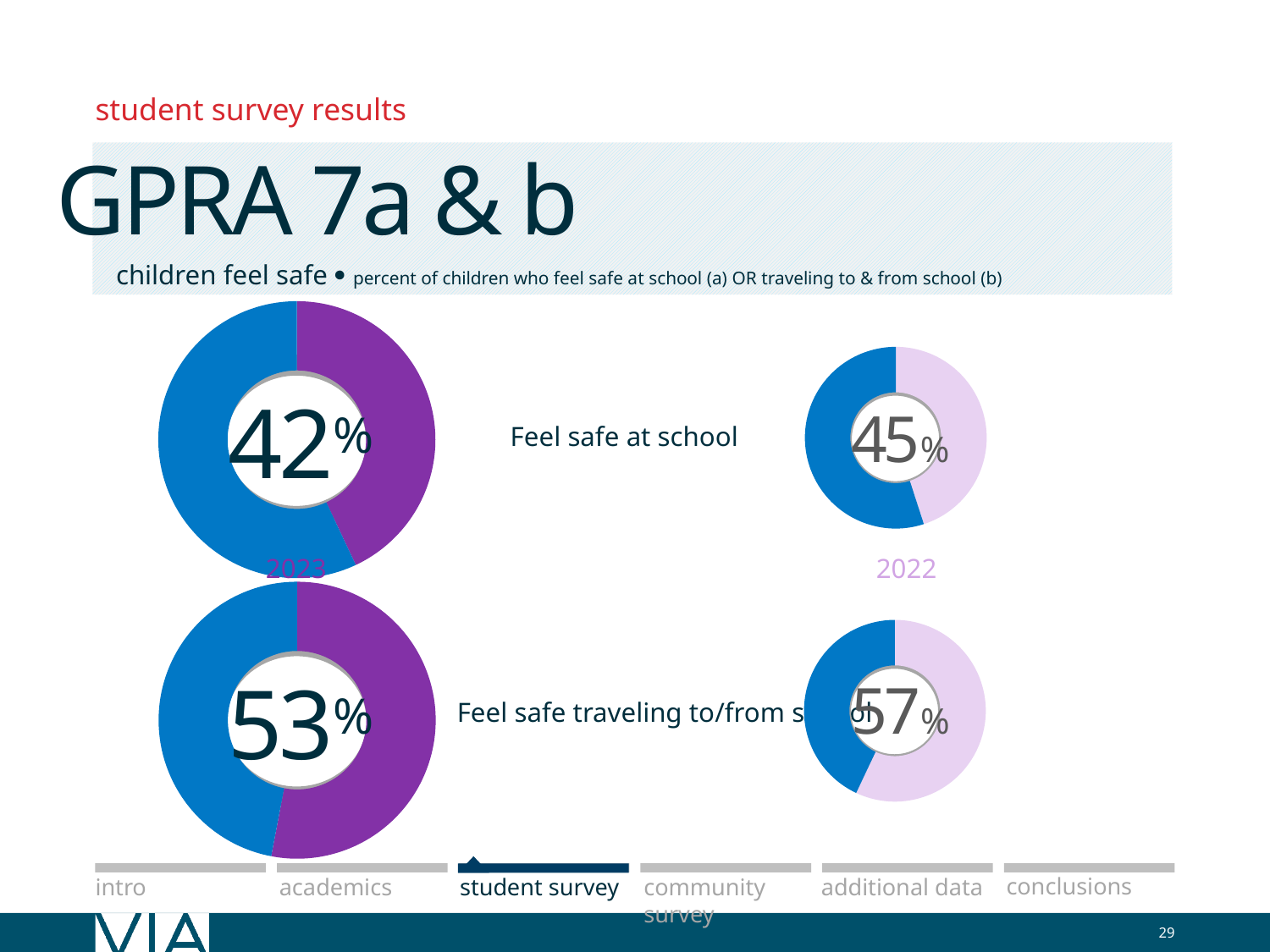
What percentage is shown in the small 2022 donut chart next to "Feel safe at school"? 45% What percentage is shown in the large 2023 donut chart next to "Feel safe at school"? 42% What is the difference between the 2022 and 2023 values for "Feel safe at school"? 3% How many donut charts are on the slide? 4 Which of the four donut charts shows the highest percentage? The 2022 "Feel safe traveling to/from school" chart (57%) What percentage is shown in the small donut chart on the right next to "Feel safe traveling to/from school"? 57% What is the difference between the 57% and 53% values for "Feel safe traveling to/from school"? 4% For "Feel safe at school", which is larger: the 2023 value (42%) or the 2022 value (45%)? 2022 (45%) Which year label appears under the small donut charts on the right? 2022 What type of chart is used to show the percentages on this slide? Donut chart Which of the four donut charts shows the lowest percentage? The 2023 "Feel safe at school" chart (42%) What percentage is shown in the large donut chart on the left next to "Feel safe traveling to/from school"? 53%